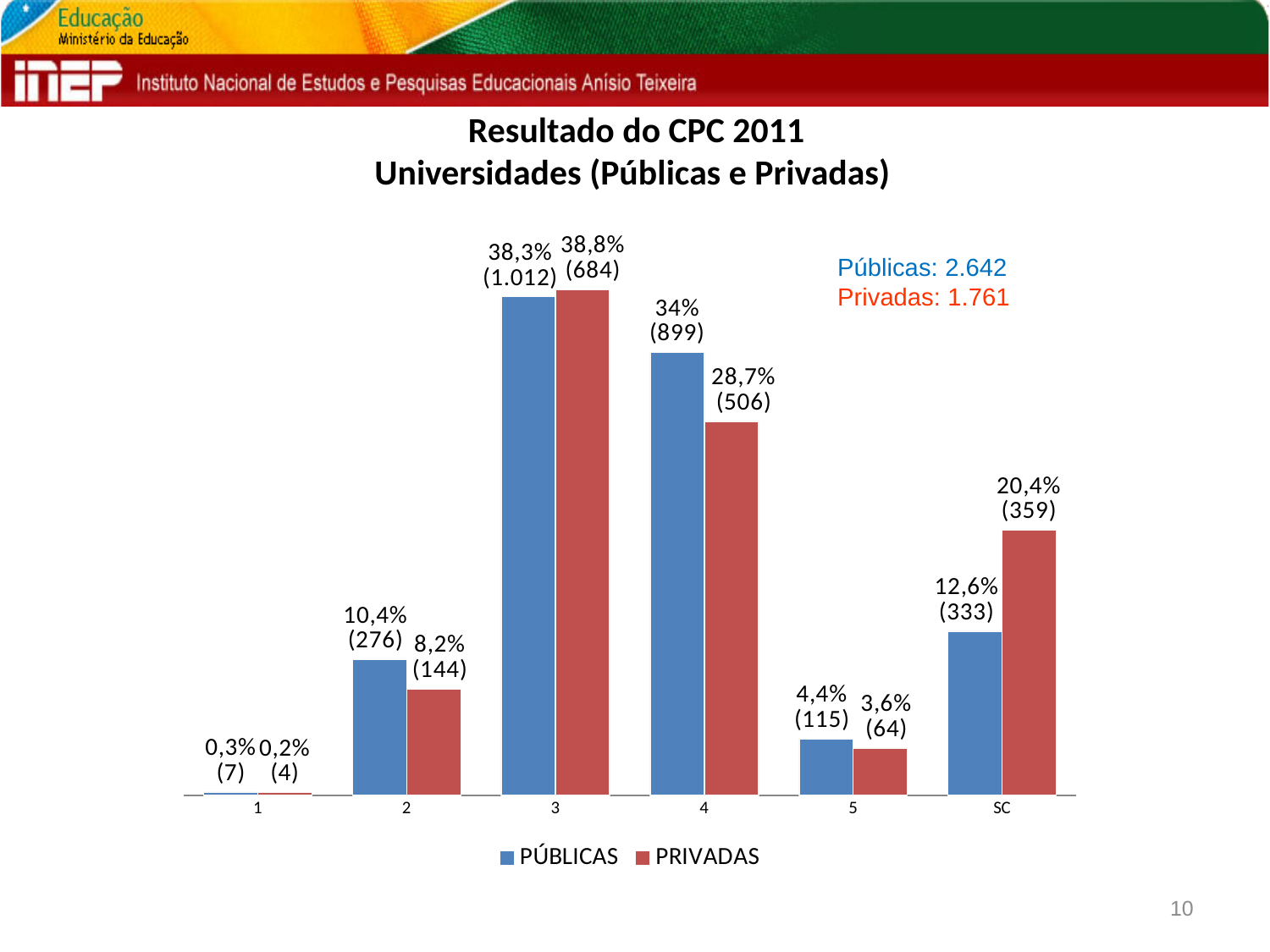
Which category has the highest percentage for PRIVADAS? 3 What percentage is shown for PRIVADAS in category SC? 20,4% How many series does the legend list? 2 What percentage is shown for PÚBLICAS in category 3? 38,3% How many universities does the label show for PÚBLICAS in category 4? 899 What kind of chart is shown on the slide? bar chart How many categories are shown on the x axis? 6 What is the total number of public universities (Públicas) stated on the slide? 2.642 What is the title of the chart? Resultado do CPC 2011 Universidades (Públicas e Privadas) Which category has the lowest percentage for PÚBLICAS? 1 Which is larger in category SC, the PÚBLICAS percentage or the PRIVADAS percentage? PRIVADAS What is the difference in percentage points between PÚBLICAS and PRIVADAS in category 4? 5,3